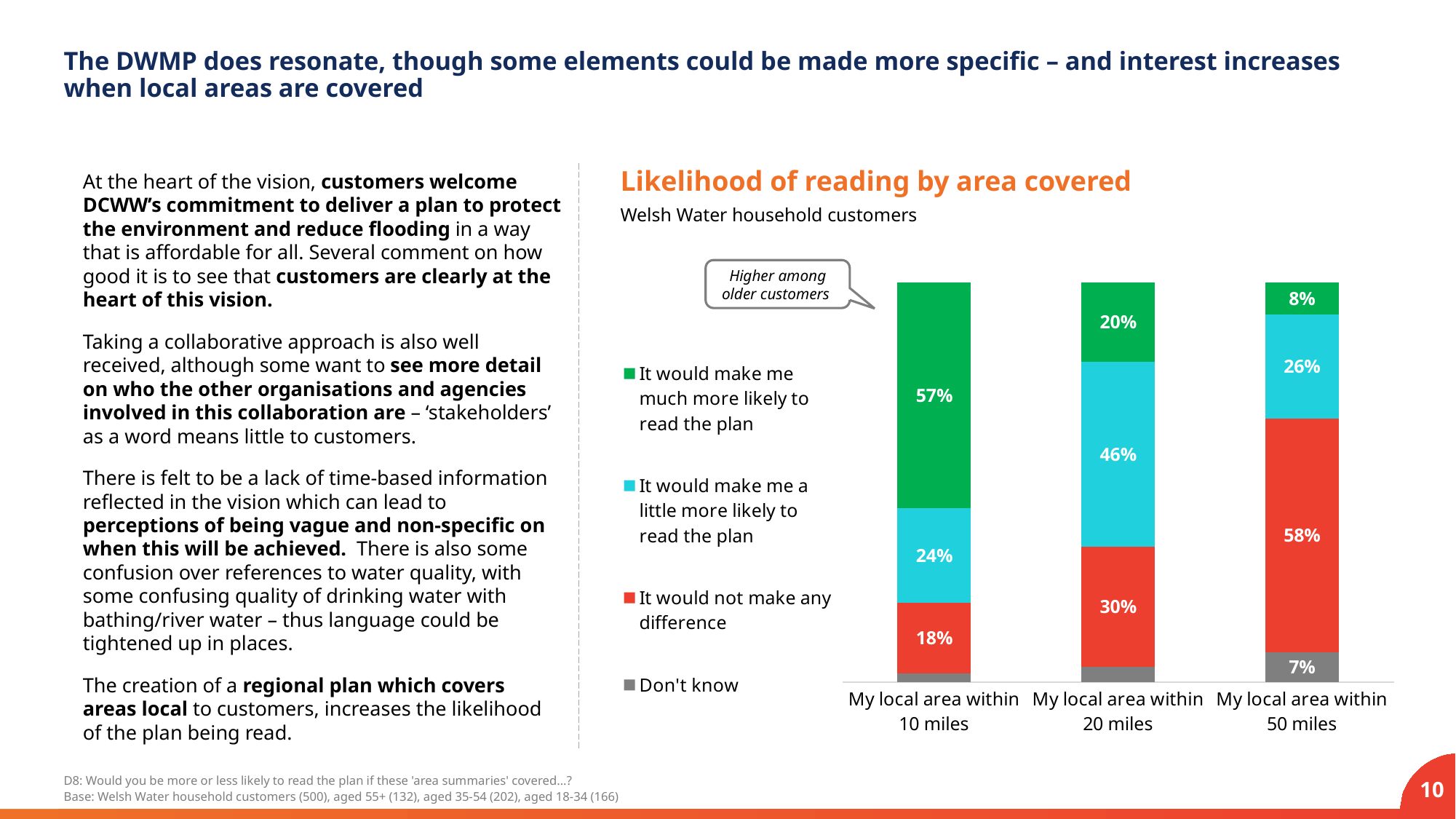
Which area category has the highest share of customers saying it would make them much more likely to read the plan? My local area within 10 miles Which has a larger 'a little more likely to read the plan' share: 'My local area within 10 miles' or 'My local area within 20 miles'? My local area within 20 miles Which area category has the lowest share of customers saying it would make them much more likely to read the plan? My local area within 50 miles What type of chart is used to show likelihood of reading by area covered? Stacked bar chart How many area categories are shown on the x axis of the chart? 3 What percentage of customers said it would make them much more likely to read the plan if it covered their local area within 10 miles? 57% What is the 'Don't know' percentage for the 'My local area within 50 miles' category? 7% What is the difference in percentage points between the 'much more likely' share for 10 miles and for 50 miles? 49 percentage points What percentage of customers said it would not make any difference for the 'My local area within 50 miles' category? 58% How many series does the chart legend list? 4 Does the 'It would not make any difference' share rise or fall as the area covered increases from 10 miles to 50 miles? Rise What percentage of customers said it would make them a little more likely to read the plan for the 'My local area within 20 miles' category? 46%